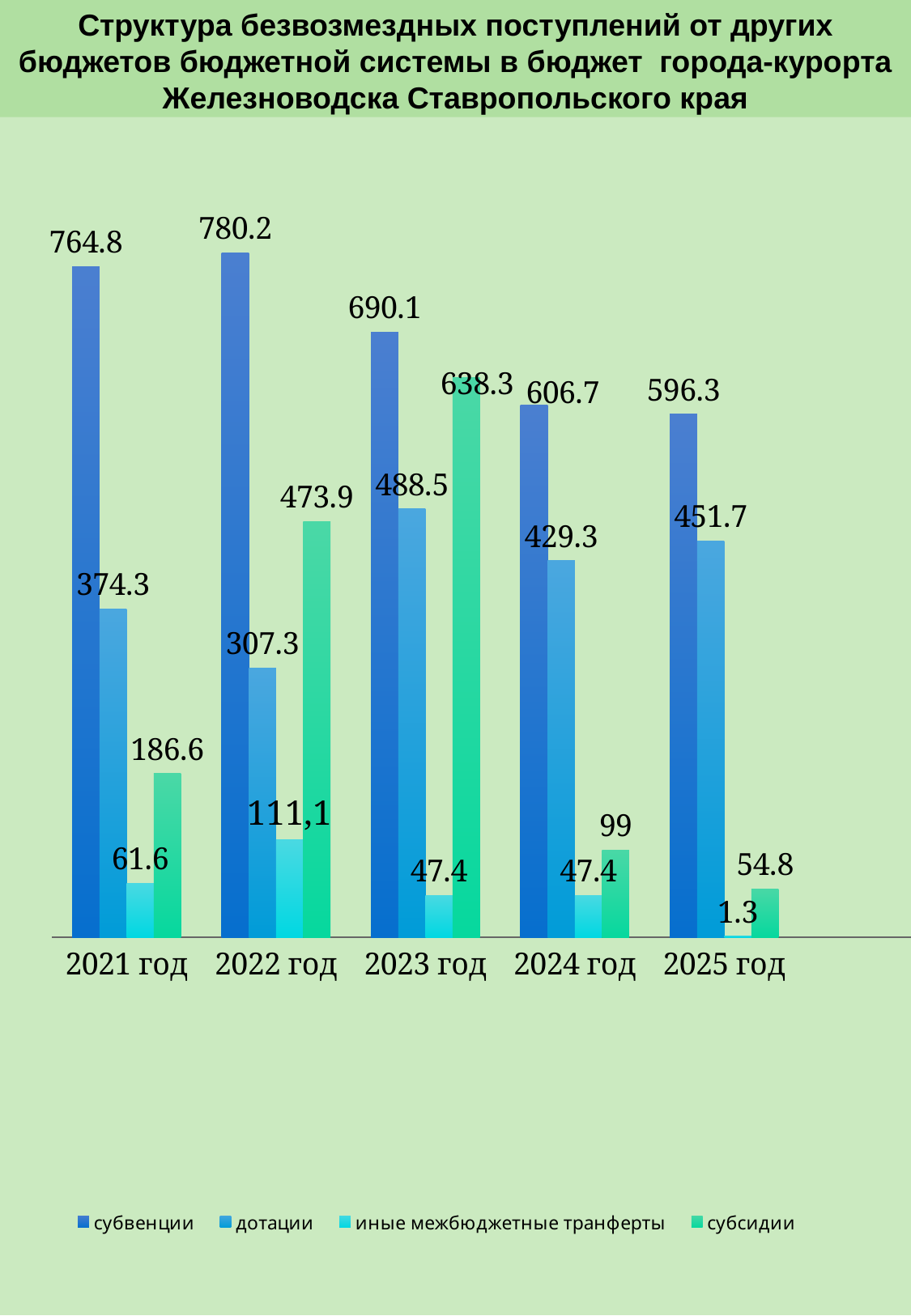
What is the value for дотации in 2025 год? 451.7 What is the value for иные межбюджетные транферты in 2022 год? 111,1 What is the value for субвенции in 2022 год? 780.2 How many years are shown on the x axis? 5 What kind of chart is shown on the slide? bar chart Which is larger in 2023 год: субвенции or субсидии? субвенции In which year is the value for иные межбюджетные транферты the lowest? 2025 год How many series does the legend list? 4 What is the value for субсидии in 2023 год? 638.3 In which year is the value for субвенции the highest? 2022 год What is the difference between субвенции in 2021 год and субвенции in 2025 год? 168.5 Do the values for субвенции rise or fall from 2022 год to 2025 год? fall